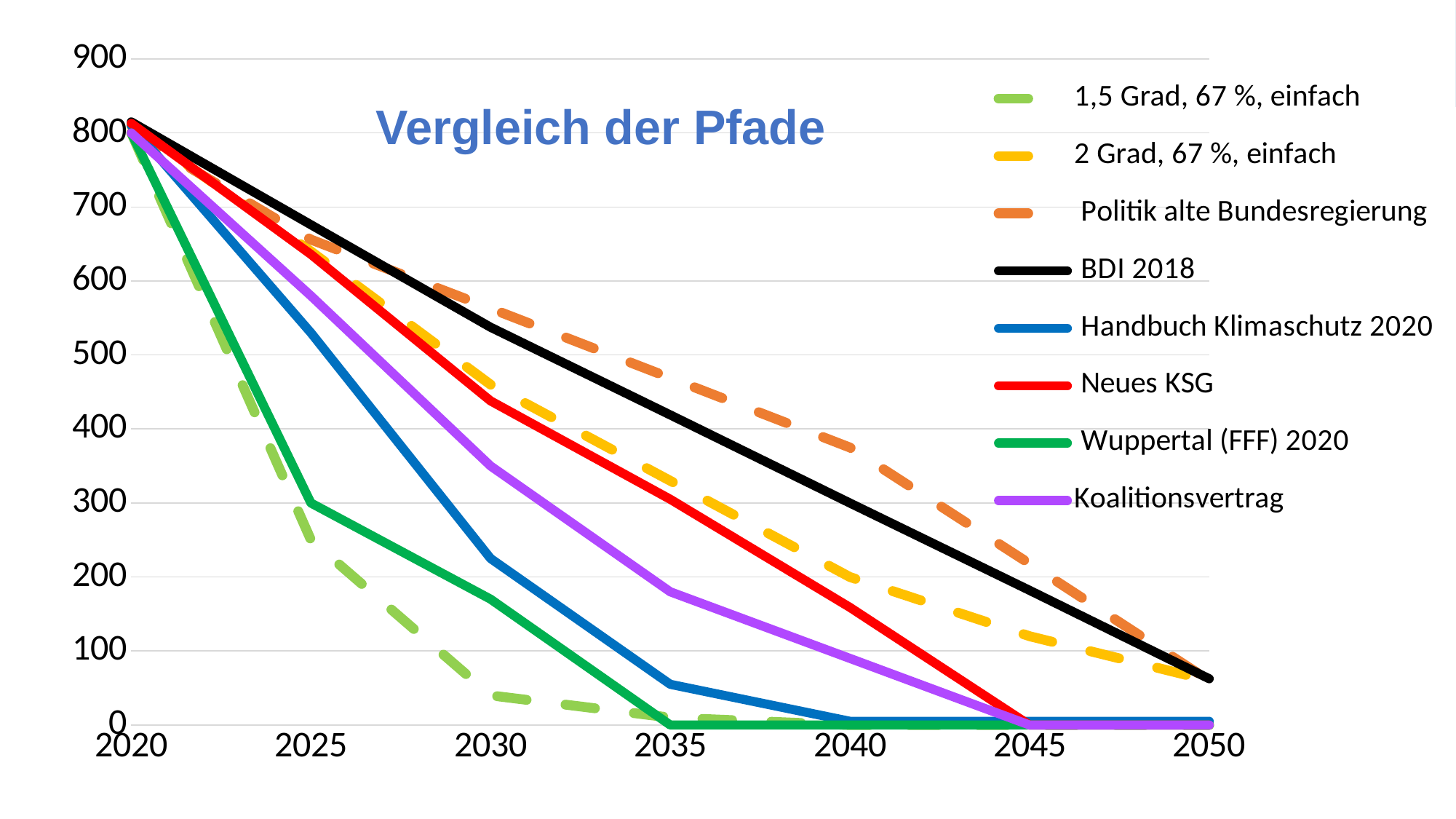
What is the title of the chart? Vergleich der Pfade What kind of chart is shown on the slide? line chart In 2035, which is larger: the value for BDI 2018 or the value for Neues KSG? BDI 2018 Which series has the highest value in 2040? Politik alte Bundesregierung What is the value of the Wuppertal (FFF) 2020 series in 2040? 0 How many series does the legend list? 8 Is the value for BDI 2018 in 2030 greater or less than 500? greater Is the value for Politik alte Bundesregierung in 2040 greater or less than 300? greater What is the value of the Neues KSG series in 2045? 0 How many year points are shown along the x axis? 7 Do the values of the BDI 2018 series rise or fall from 2020 to 2050? fall Is the value for Koalitionsvertrag in 2035 greater or less than 200? less